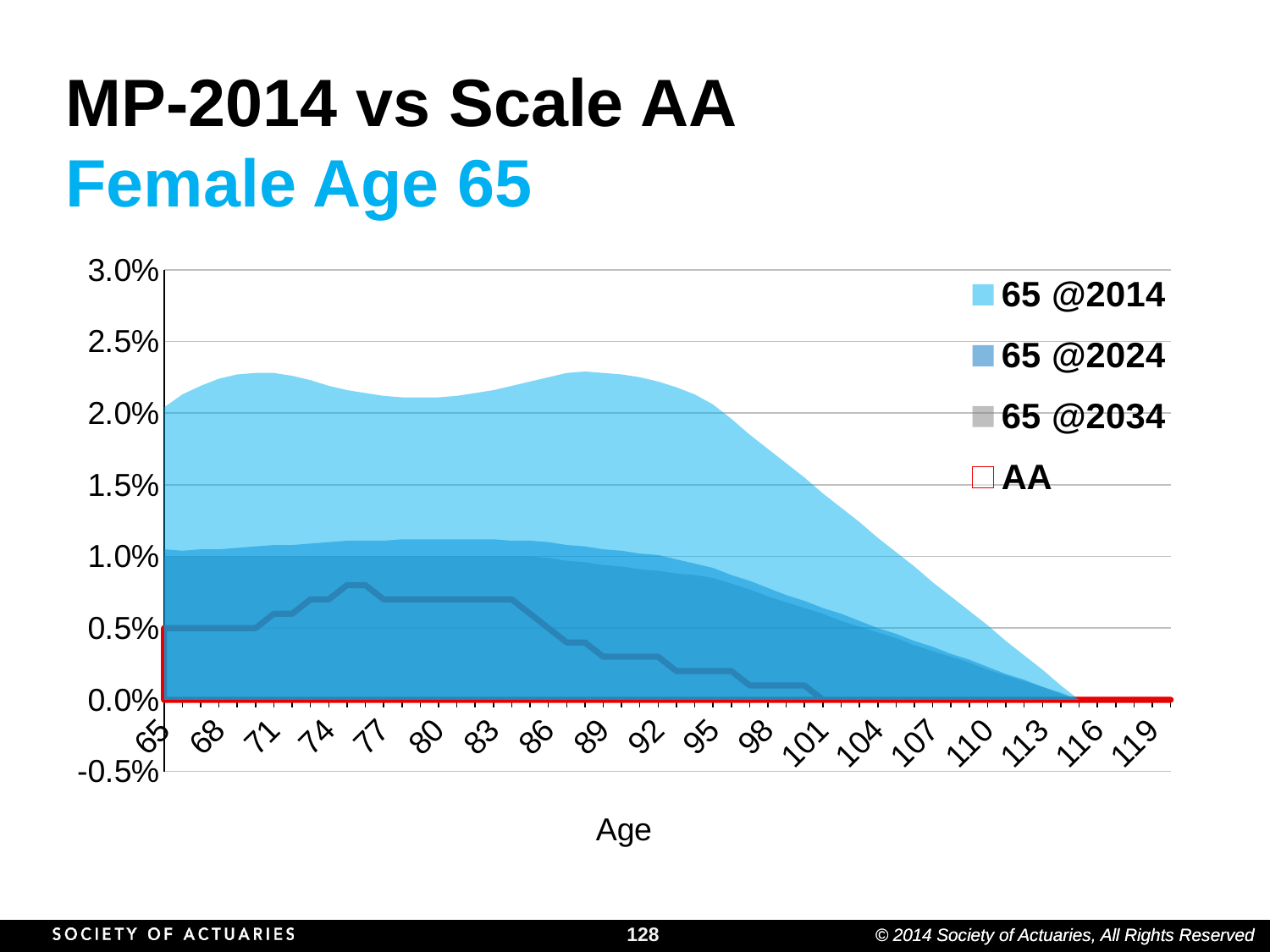
Is the value of the 65 @2034 series at age 92 greater or less than 0.5%? greater Is the value of the 65 @2014 series at age 107 greater or less than 1.0%? less How many series does the legend list? 4 Is the value of the 65 @2024 series at age 110 greater or less than 0.5%? less Does the 65 @2014 series rise or fall between age 95 and age 116? fall What is the title of the x axis? Age What kind of chart is shown on the slide? area chart